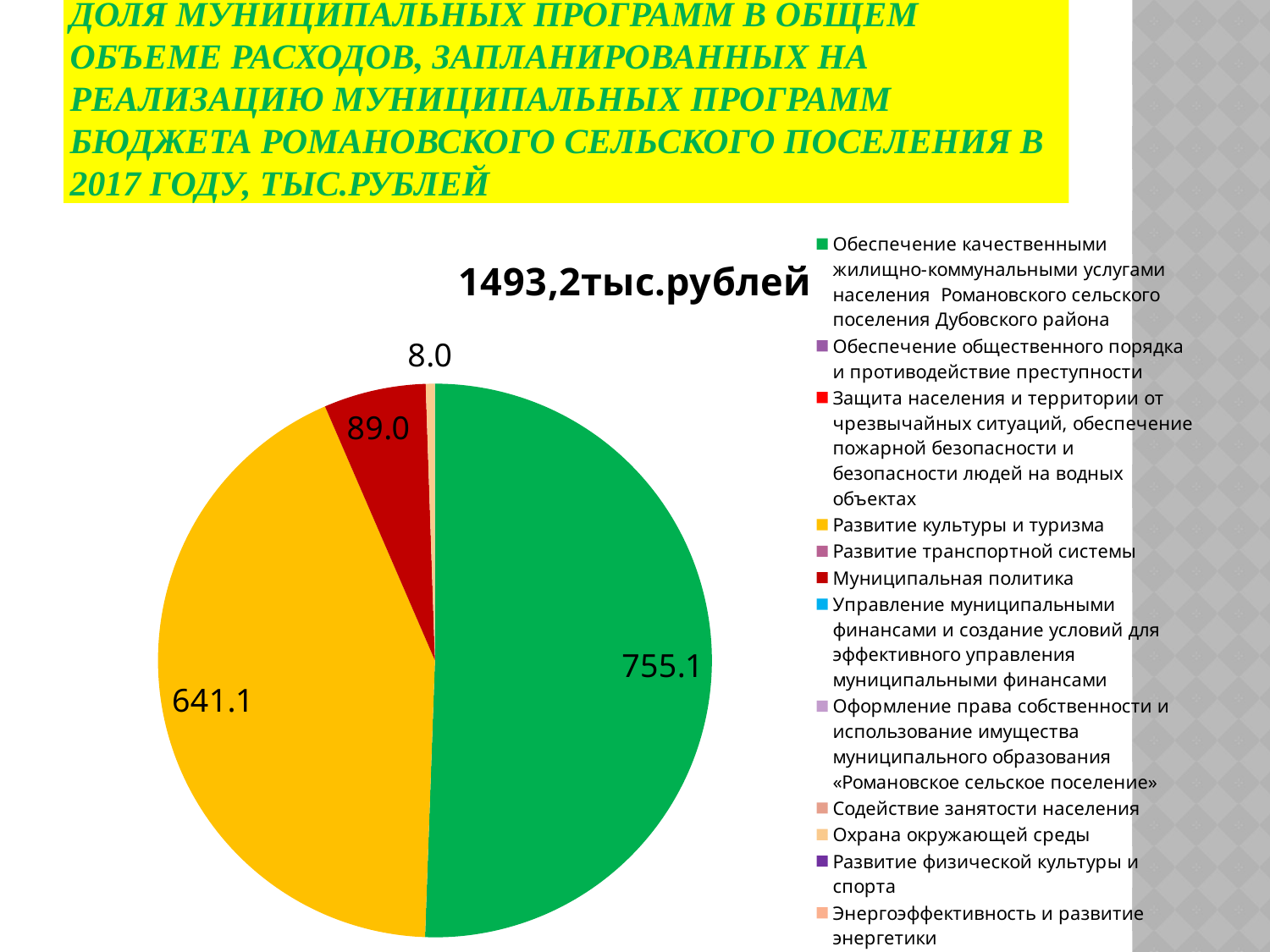
How many data labels are printed on the pie chart? 4 What is the value of the green slice (Обеспечение качественными жилищно-коммунальными услугами населения)? 755.1 Which is larger: the slice for Развитие культуры и туризма or the dark red slice labelled 89.0? Развитие культуры и туризма (641.1) What kind of chart is shown on the slide? pie chart What is the difference between the 89.0 slice and the 8.0 slice? 81.0 How many entries does the legend list? 12 What is the value of the yellow slice (Развитие культуры и туризма)? 641.1 What colour is the largest slice of the pie? green What is the title shown above the pie chart? 1493,2тыс.рублей What is the smallest value labelled on the pie chart? 8.0 What is the difference between the 755.1 slice and the 641.1 slice? 114.0 Which slice of the pie is the largest? Обеспечение качественными жилищно-коммунальными услугами населения (755.1)